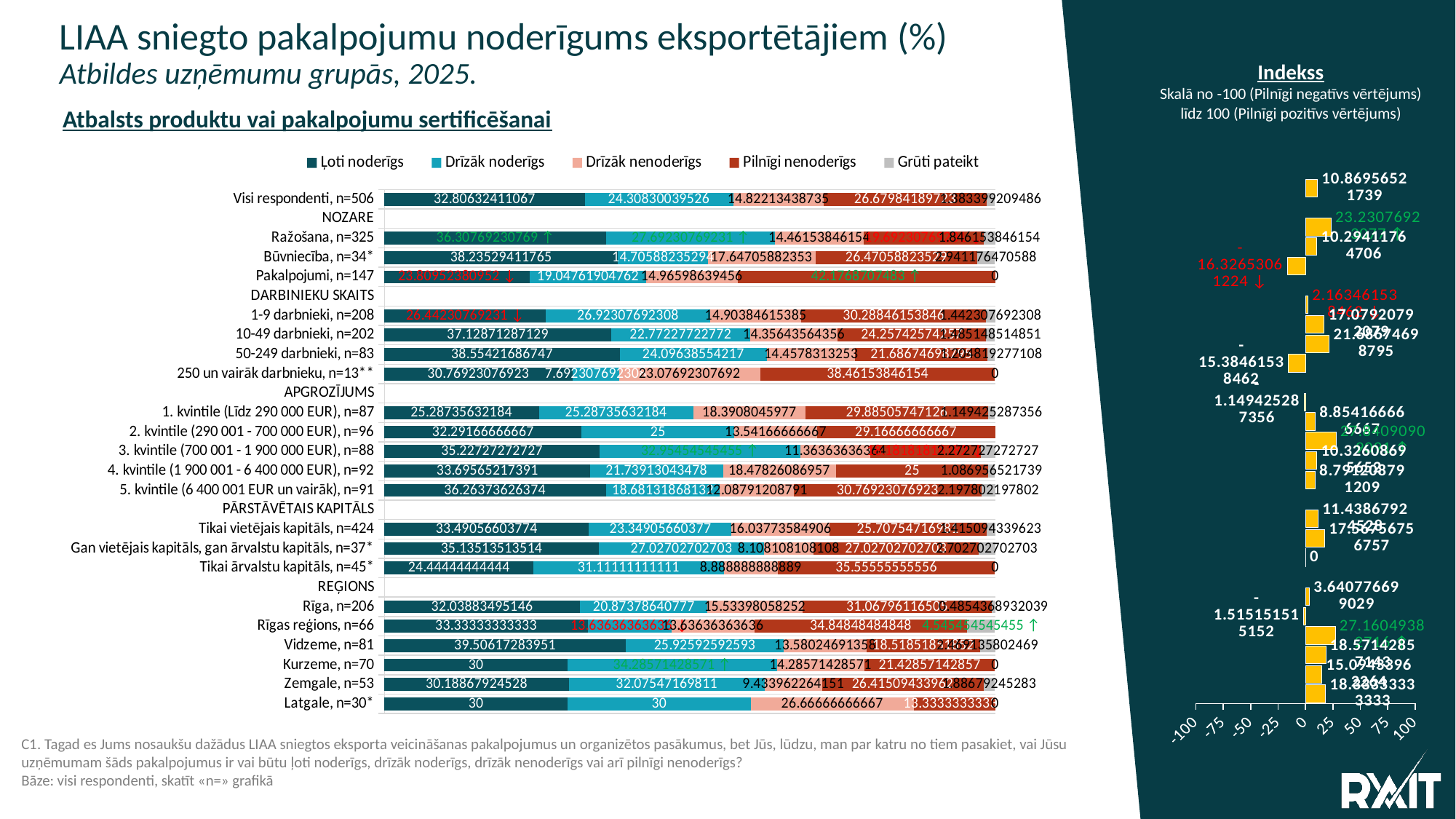
In the stacked bar chart 'Atbalsts produktu vai pakalpojumu sertificēšanai', what is the 'Grūti pateikt' value for Tikai ārvalstu kapitāls, n=45*? 0 In the stacked bar chart 'Atbalsts produktu vai pakalpojumu sertificēšanai', what is the 'Drīzāk noderīgs' value for Kurzeme, n=70? 34.28571428571 In the stacked bar chart 'Atbalsts produktu vai pakalpojumu sertificēšanai', what is the 'Ļoti noderīgs' value for Vidzeme, n=81? 39.50617283951 In the stacked bar chart 'Atbalsts produktu vai pakalpojumu sertificēšanai', which is larger for Būvniecība, n=34*: 'Ļoti noderīgs' or 'Drīzāk noderīgs'? Ļoti noderīgs In the stacked bar chart 'Atbalsts produktu vai pakalpojumu sertificēšanai', what is the difference between the 'Ļoti noderīgs' and 'Drīzāk noderīgs' values for Latgale, n=30*? 0 In the 'Indekss' bar chart on the right, what is the index value for Tikai ārvalstu kapitāls, n=45*? 0 In the 'Indekss' bar chart on the right, is the index value for Pakalpojumi, n=147 greater or less than 0? less What kind of chart is 'Atbalsts produktu vai pakalpojumu sertificēšanai'? Stacked bar chart In the stacked bar chart 'Atbalsts produktu vai pakalpojumu sertificēšanai', what is the 'Drīzāk nenoderīgs' value for Latgale, n=30*? 26.66666666667 In the stacked bar chart 'Atbalsts produktu vai pakalpojumu sertificēšanai', what is the 'Pilnīgi nenoderīgs' value for Pakalpojumi, n=147? 42.1768707483 How many series does the legend of the stacked bar chart 'Atbalsts produktu vai pakalpojumu sertificēšanai' list? 5 In the stacked bar chart 'Atbalsts produktu vai pakalpojumu sertificēšanai', what is the 'Pilnīgi nenoderīgs' value for 250 un vairāk darbinieku, n=13**? 38.46153846154